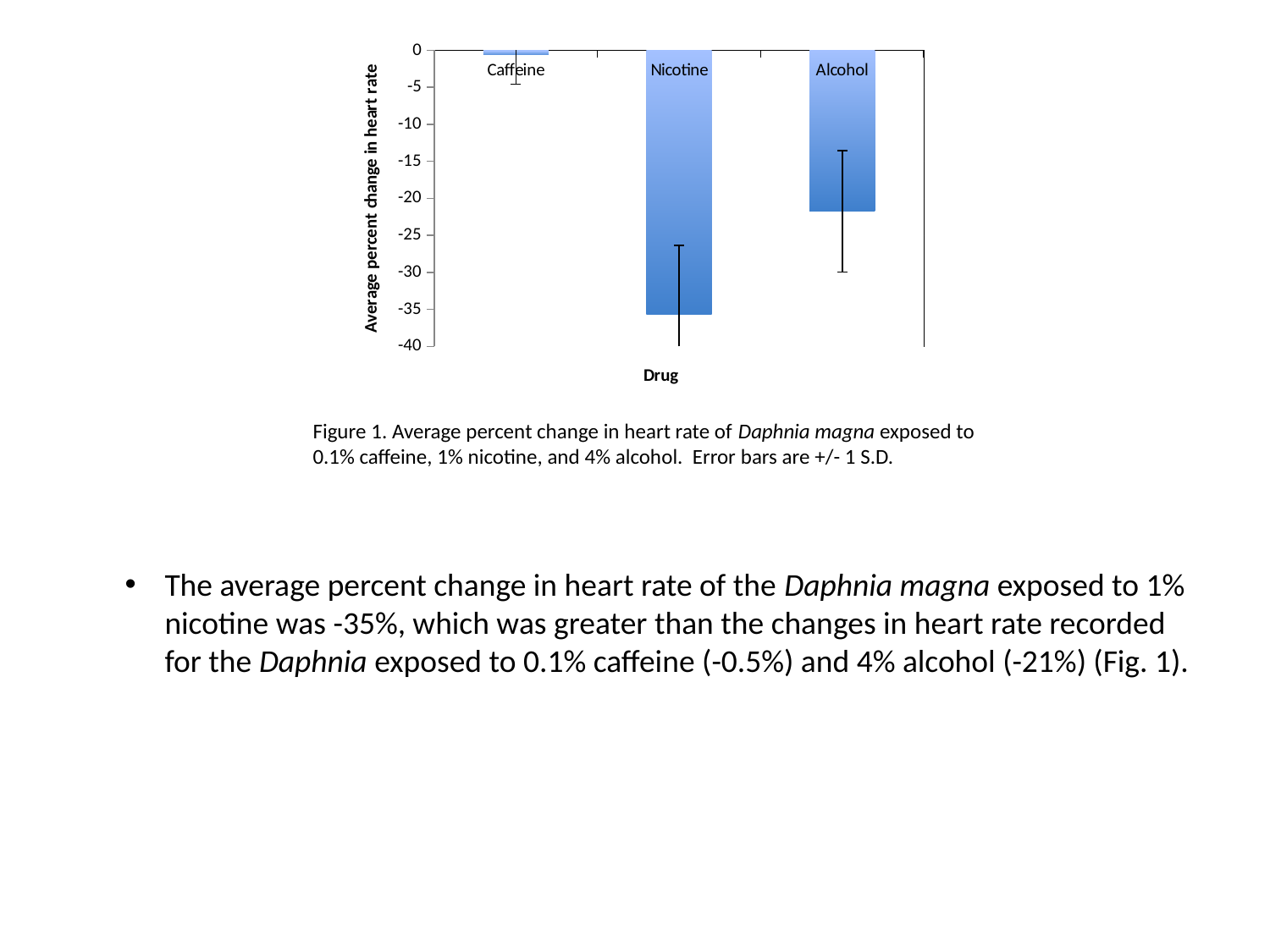
Is the value for Alcohol greater or less than -25? greater Is the value for Alcohol greater or less than -15? less Is the value for Nicotine greater or less than -30? less Which drug has the highest (closest to zero) average percent change in heart rate? Caffeine How many drugs are plotted on the chart? 3 Which drug shows the largest decrease in average percent change in heart rate? Nicotine What is the label of the y axis? Average percent change in heart rate Which has a larger (less negative) average percent change in heart rate, Caffeine or Alcohol? Caffeine What is the label of the x axis? Drug What kind of chart is shown on the slide? bar chart Which has a larger (less negative) average percent change in heart rate, Alcohol or Nicotine? Alcohol